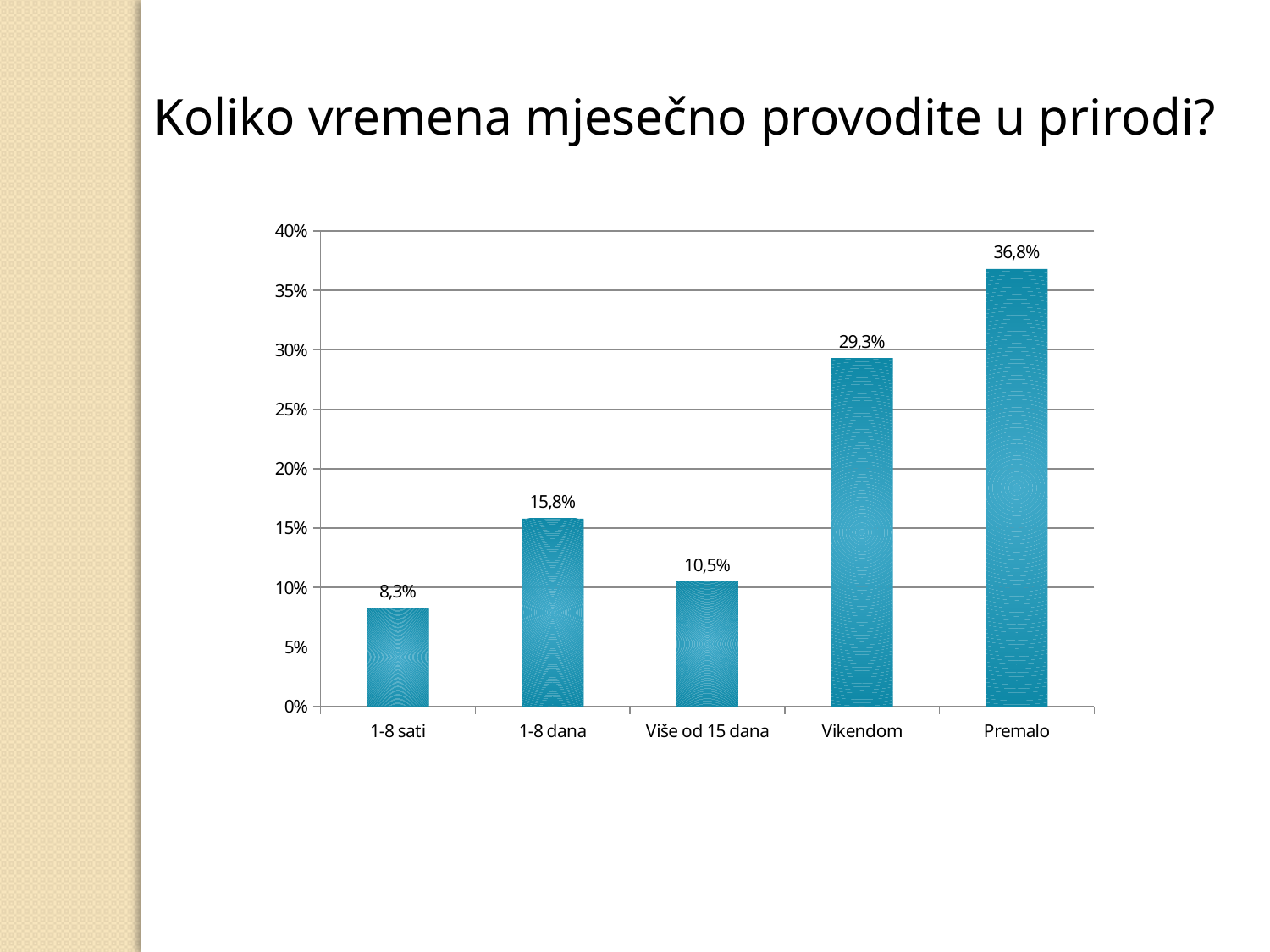
What is the value for 1-8 sati? 8,3% What kind of chart is shown on the slide? bar chart What is the value for Vikendom? 29,3% What is the difference between the values for Premalo and Vikendom? 7,5% Which is larger, the value for 1-8 dana or the value for Više od 15 dana? 1-8 dana How many categories are shown on the x axis? 5 What is the difference between the values for 1-8 dana and 1-8 sati? 7,5% Which category has the lowest value? 1-8 sati Is the value for Vikendom greater or less than 25%? greater What is the value for Više od 15 dana? 10,5% Which category has the highest value? Premalo What is the value for Premalo? 36,8%